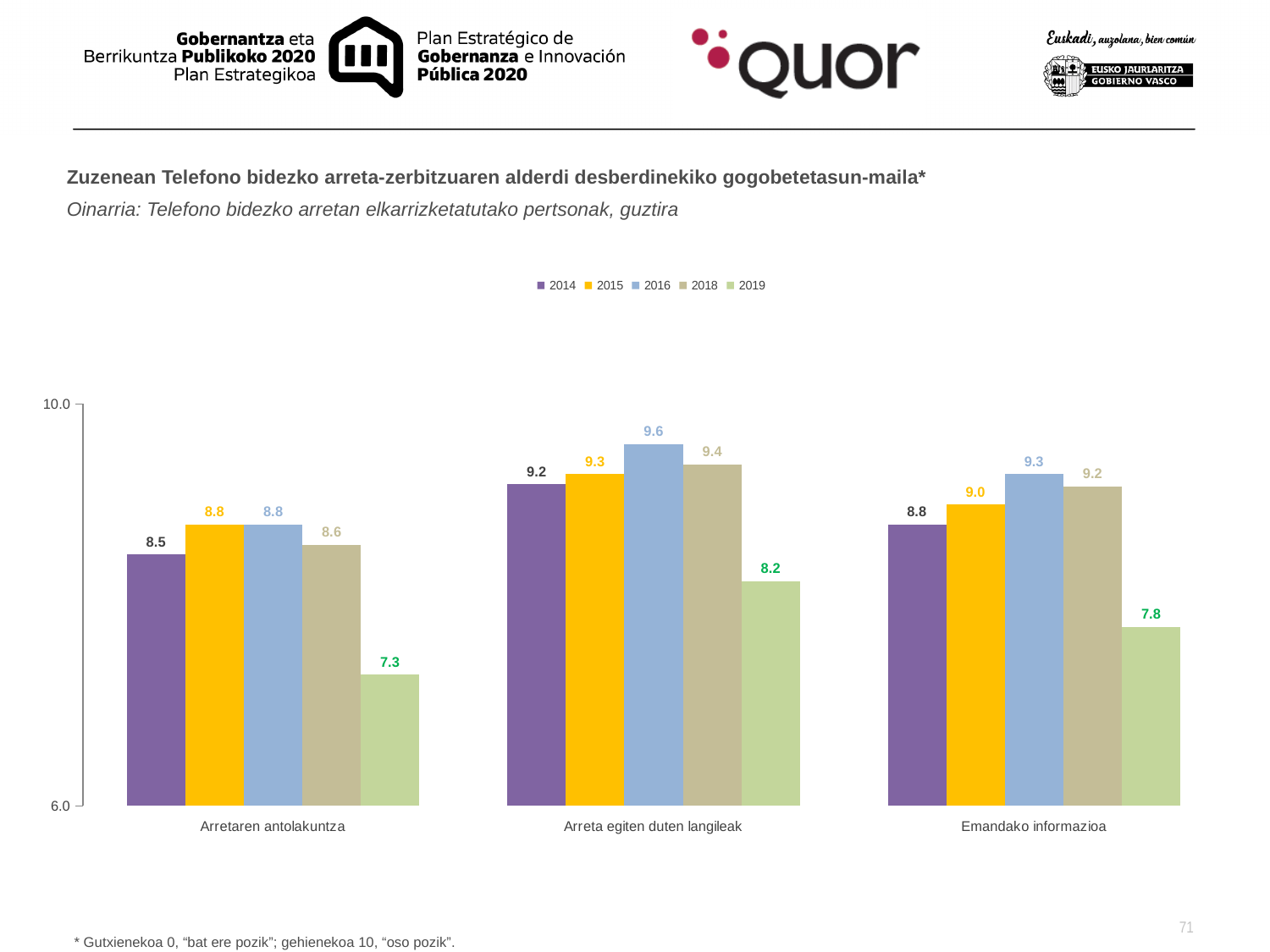
Which years are listed in the legend? 2014, 2015, 2016, 2018, 2019 What is the difference between the 2016 and 2019 values in the Emandako informazioa category? 1.5 What is the value for 2019 in the Arretaren antolakuntza category? 7.3 What is the value for 2015 in the Emandako informazioa category? 9.0 What is the difference between the 2018 and 2019 values in the Arreta egiten duten langileak category? 1.2 What is the value for 2016 in the Arreta egiten duten langileak category? 9.6 Which year has the highest value in the Emandako informazioa category? 2016 How many series does the legend list? 5 What kind of chart is shown on the slide? Bar chart Which is larger: the 2014 value for Arretaren antolakuntza or the 2014 value for Emandako informazioa? Emandako informazioa How many categories are shown on the x axis? 3 Which year has the lowest value in the Arreta egiten duten langileak category? 2019